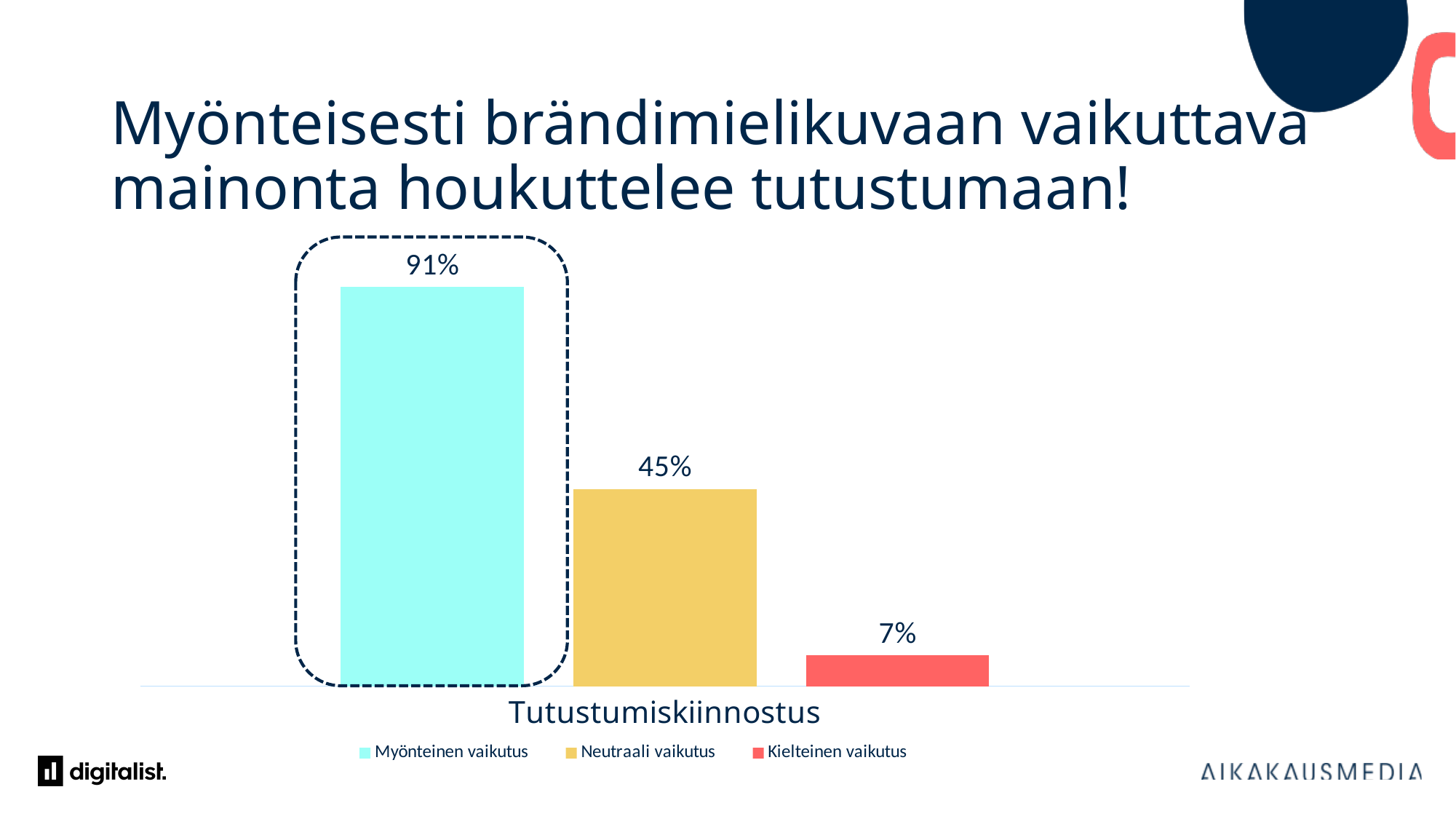
What is the category label shown on the x axis? Tutustumiskiinnostus Which series is highlighted with a dashed outline? Myönteinen vaikutus What is the difference between the values for Myönteinen vaikutus and Neutraali vaikutus? 46% Which series has the highest value? Myönteinen vaikutus How many series does the legend list? 3 What kind of chart is shown on the slide? Bar chart What is the difference between the values for Neutraali vaikutus and Kielteinen vaikutus? 38% What is the value for Myönteinen vaikutus? 91% Which is larger, the value for Neutraali vaikutus or Kielteinen vaikutus? Neutraali vaikutus Which series has the lowest value? Kielteinen vaikutus What is the value for Kielteinen vaikutus? 7% What is the value for Neutraali vaikutus? 45%